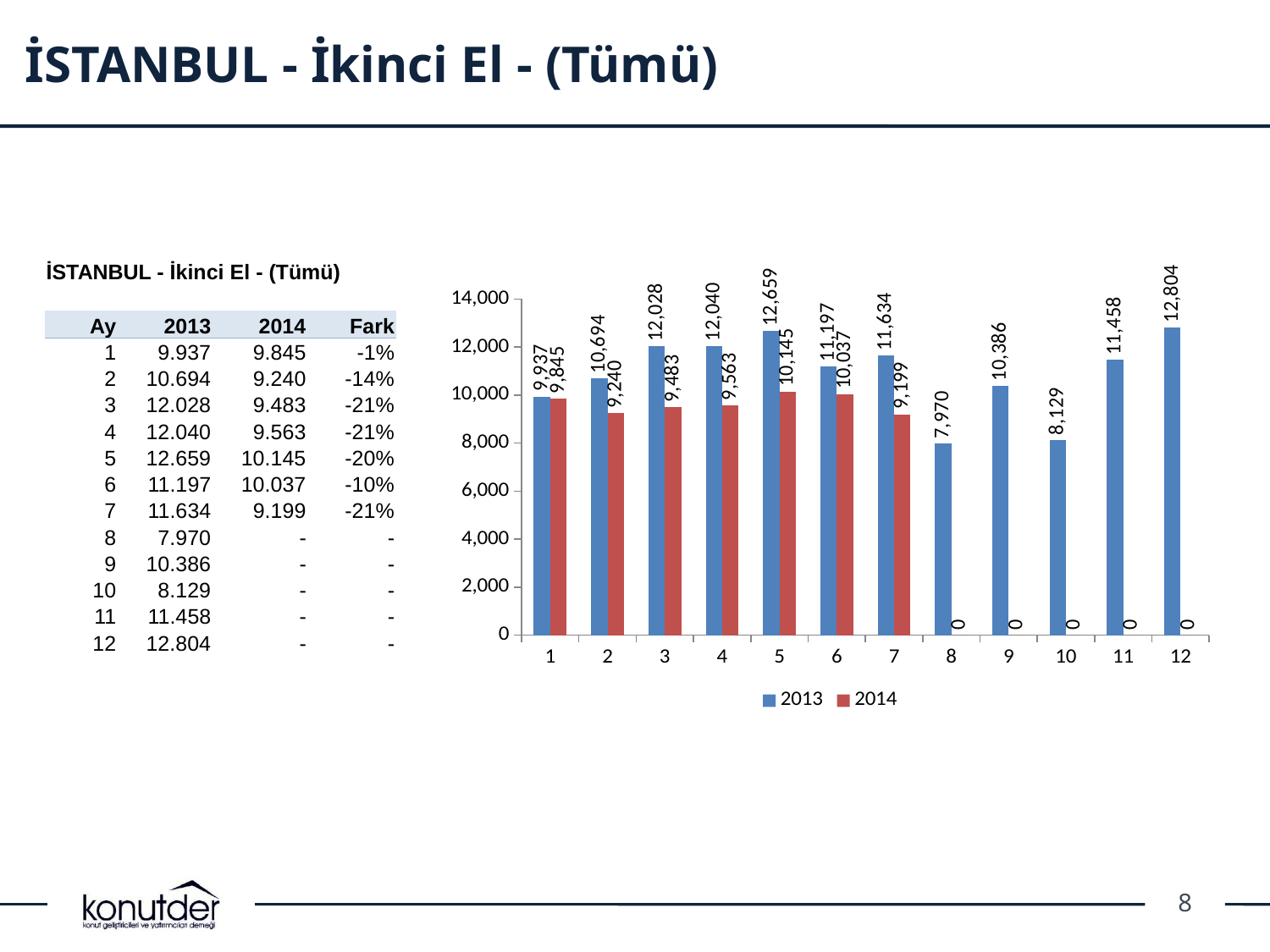
Which is larger in month 1, the 2013 value or the 2014 value? 2013 How many months are shown on the x axis? 12 What is the value for 2014 in month 2? 9,240 Which month has the highest value for the 2013 series? 12 What kind of chart is shown on the slide? bar chart Which month has the lowest value for the 2013 series? 8 What is the value for 2013 in month 5? 12,659 What is the difference between the 2013 and 2014 values in month 5? 2,514 Among months 1 to 7, which month has the highest value for the 2014 series? 5 Is the 2013 value for month 10 greater or less than 10,000? less How many series does the legend list? 2 What is the value for 2014 in month 6? 10,037